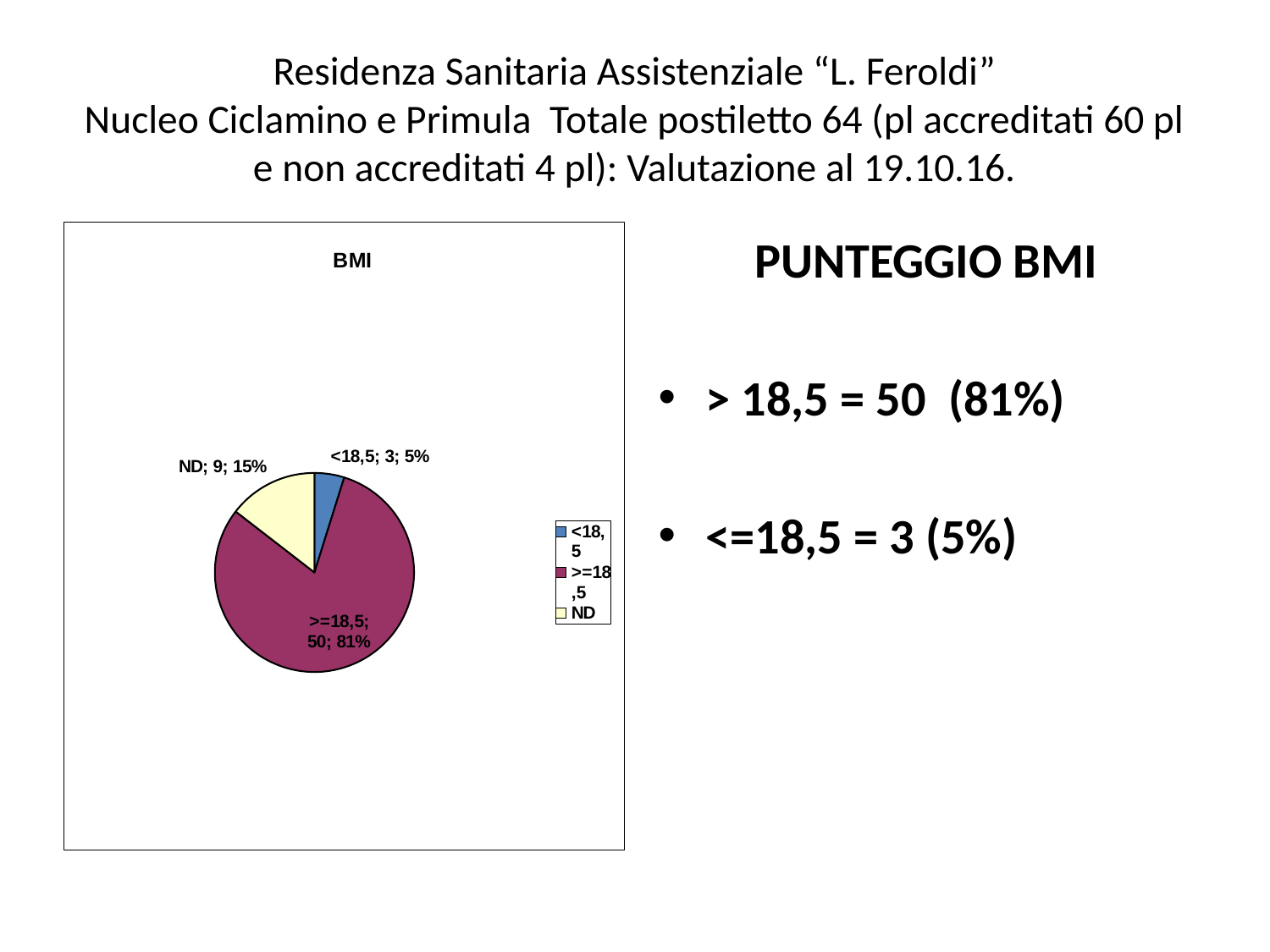
What is the value for the >=18,5 slice? 50 What is the value for the ND slice? 9 Which slice is the largest? >=18,5 What is the difference between the >=18,5 value and the ND value? 41 What is the title of the chart? BMI What is the value for the <18,5 slice? 3 What share of the pie does the >=18,5 slice represent? 81% How many entries does the legend list? 3 Which slice is the smallest? <18,5 How many slices does the pie chart have? 3 What type of chart is shown on the slide? pie chart What share of the pie does the ND slice represent? 15%